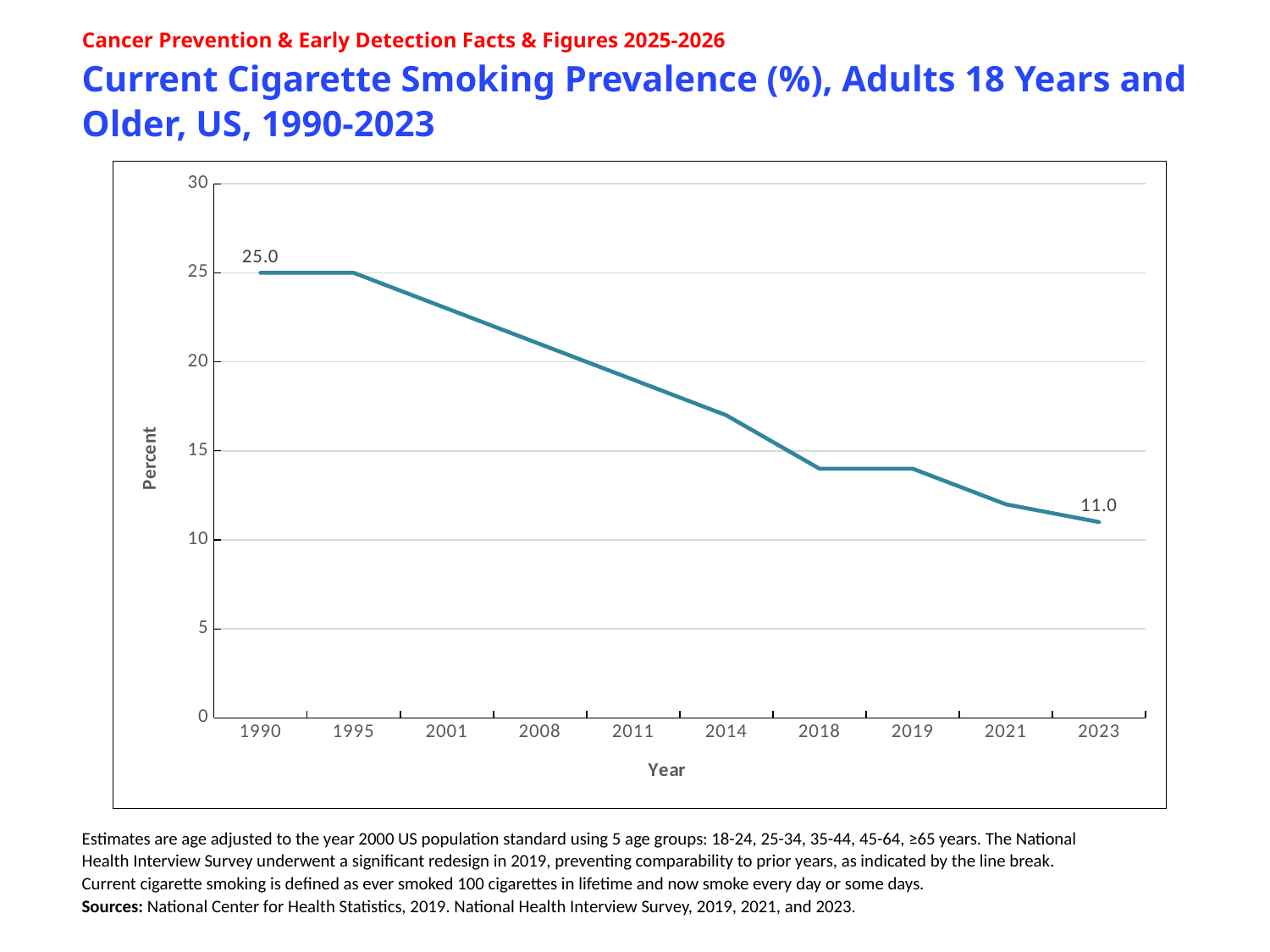
What kind of chart is shown on the slide? line chart Is the value for 2014 greater or less than 20? less Is the value for 2018 greater or less than 15? less What is the smoking prevalence value shown for 2023? 11.0 How many years are plotted on the x axis? 10 What is the difference between the 1990 value and the 2023 value? 14.0 What is the label on the vertical axis? Percent Is the value for 2001 greater or less than 20? greater Do the values rise or fall from 1990 to 2023? fall Which year has the lowest smoking prevalence? 2023 Which year has the larger value, 2011 or 2021? 2011 What is the smoking prevalence value shown for 1990? 25.0